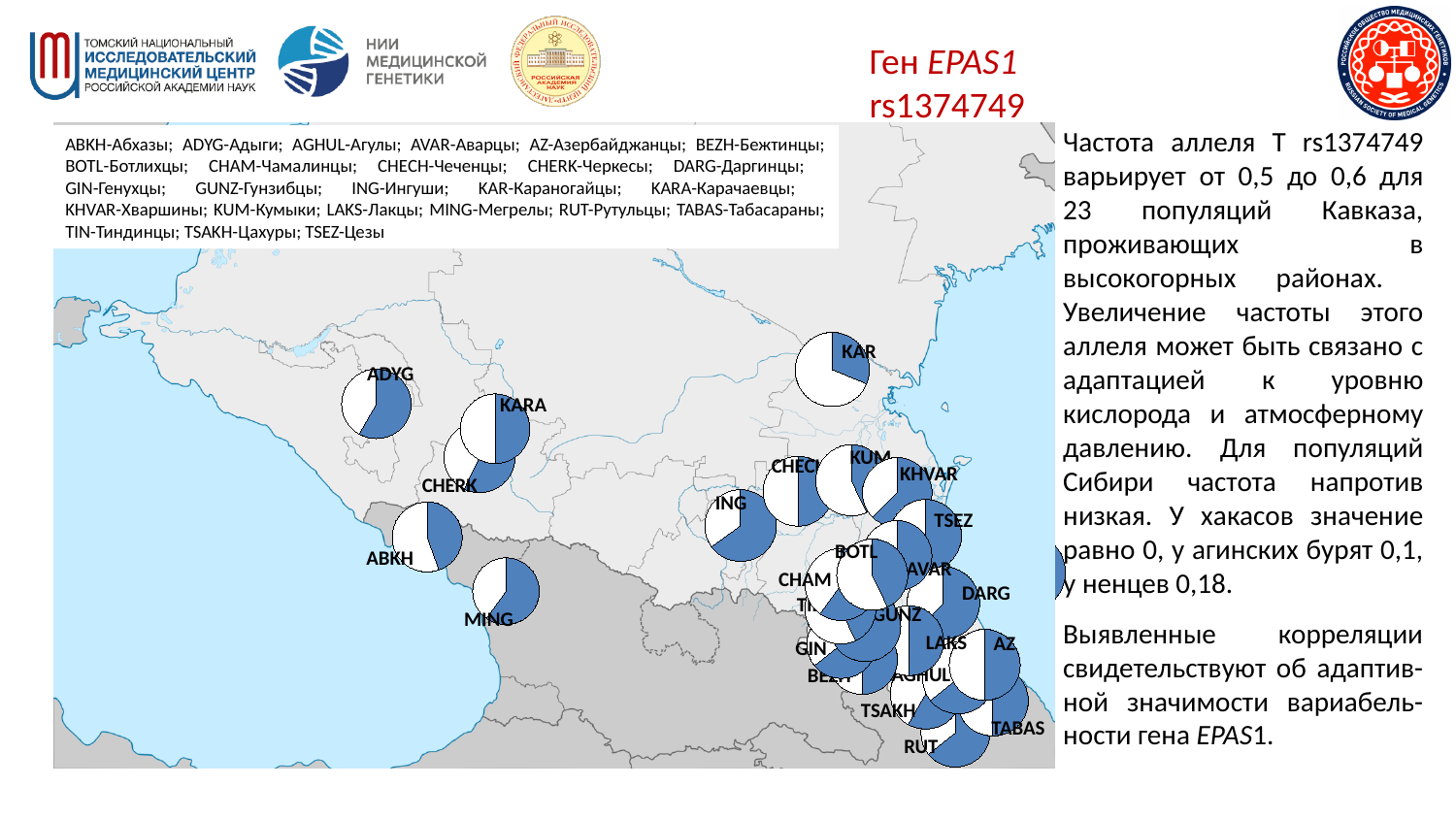
Which population does the abbreviation KAR stand for in the map legend? Караногайцы Which gene and SNP are the pie charts on the map about? EPAS1, rs1374749 Is the blue share of the pie chart for ADYG larger or smaller than the blue share of the pie chart for KAR? larger What kind of chart is used to show the allele frequencies for each population on the map? pie chart